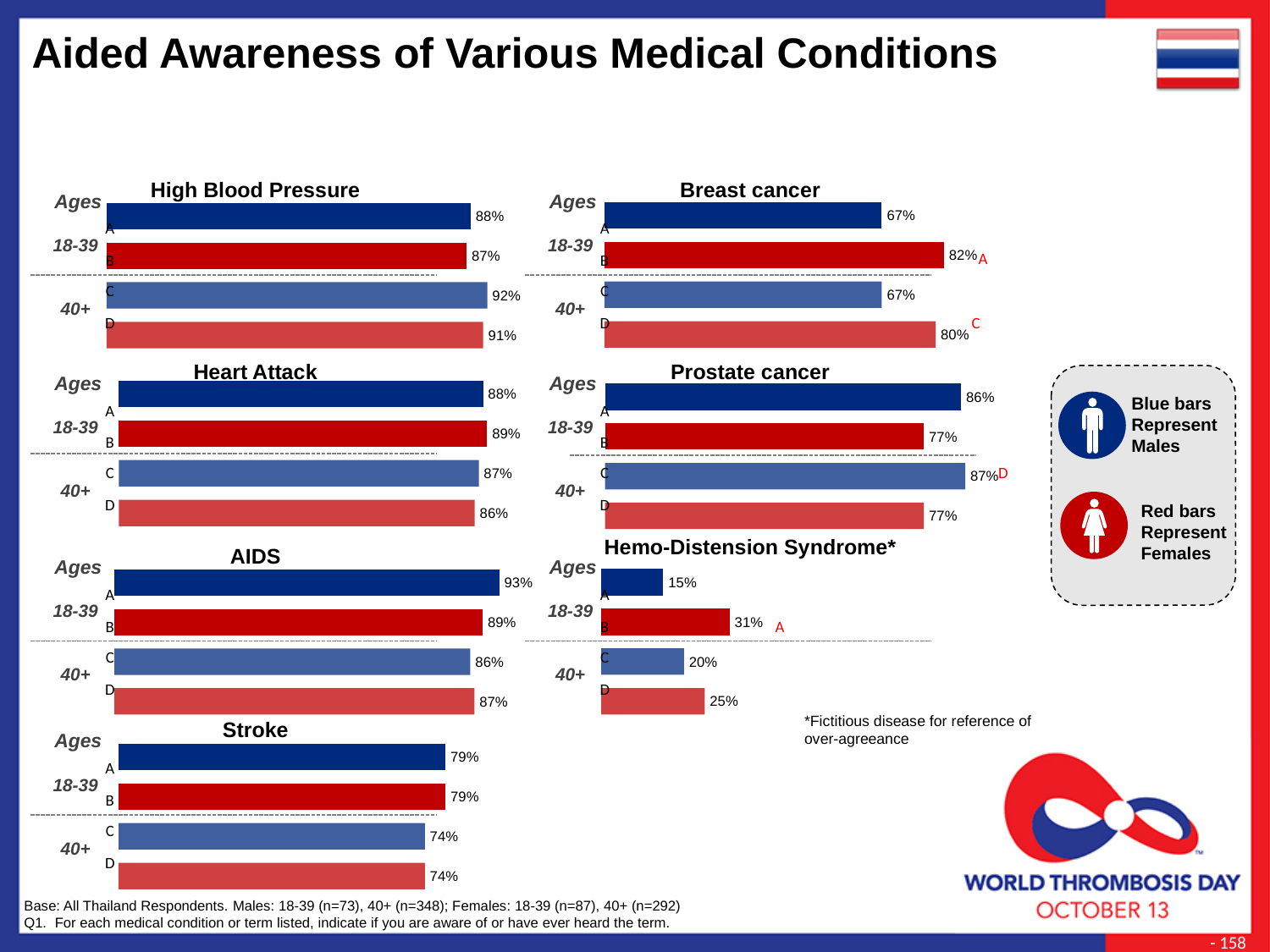
What type of chart is used for the Heart Attack data? Bar chart In the Breast cancer chart, what is the difference between bar B (82%) and bar A (67%)? 15 percentage points In the Hemo-Distension Syndrome* chart, what is the value for bar A (males aged 18-39)? 15% In the Breast cancer chart, what is the value for bar B (females aged 18-39)? 82% In the Stroke chart, what is the value for bar D (females aged 40+)? 74% How many bars are shown in the Heart Attack chart? 4 According to the legend on the slide, what do the red bars represent? Females In the Hemo-Distension Syndrome* chart, what is the difference between bar B (31%) and bar D (25%)? 6 percentage points In the Prostate cancer chart, which is larger: bar A (males 18-39) or bar B (females 18-39)? Bar A (86%) In the High Blood Pressure chart, what is the value for bar C (males aged 40+)? 92% In the AIDS chart, which bar has the highest value? A (males 18-39), 93% In the Hemo-Distension Syndrome* chart, which bar has the lowest value? A (males 18-39), 15%